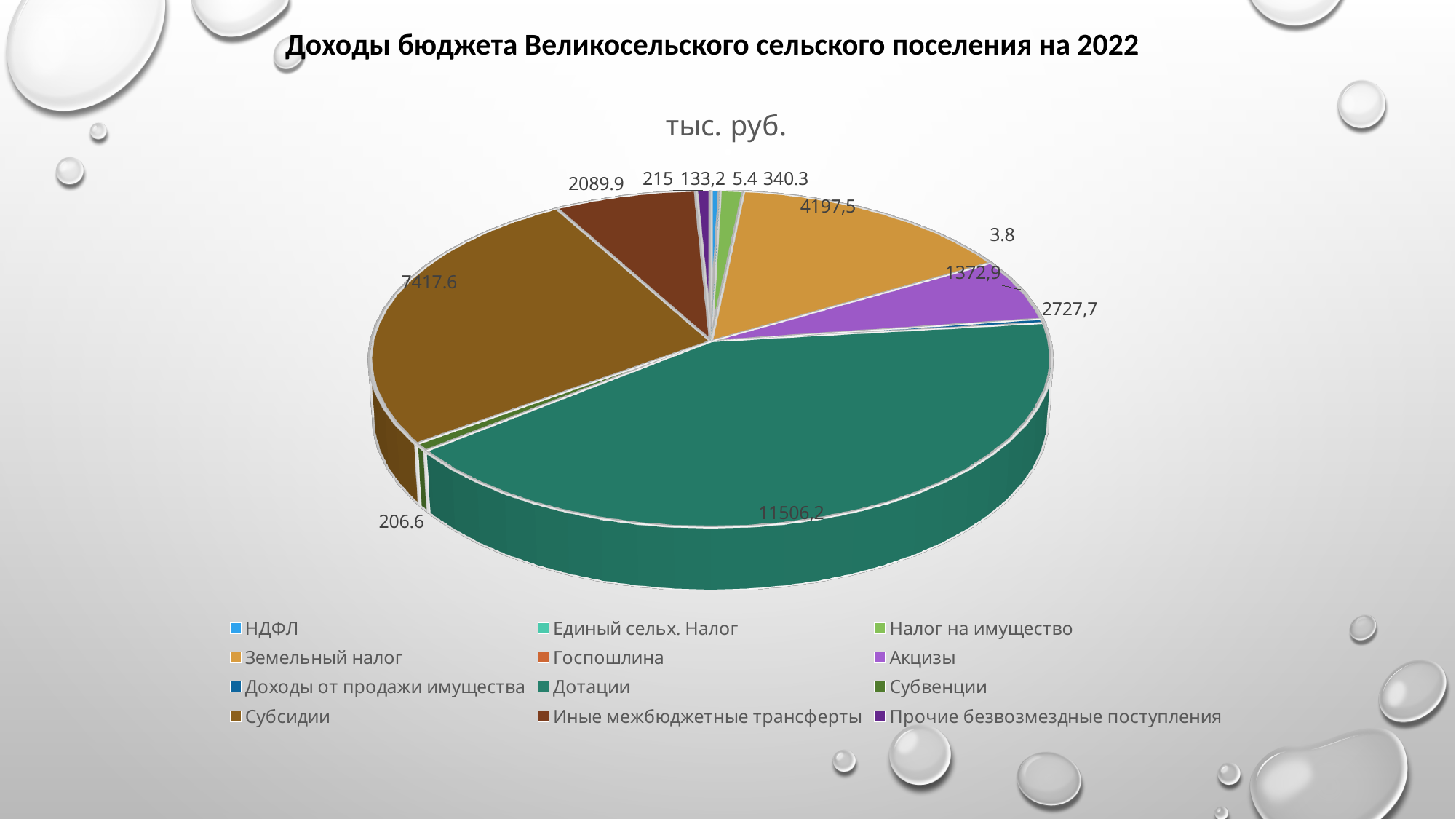
Which category has the largest slice of the pie? Дотации What colour is the slice for Дотации? teal (green) How many categories does the legend list? 12 What kind of chart is shown on the slide? pie chart What is the value for Акцизы? 1372,9 What is the value for Дотации? 11506,2 Which is larger, Субсидии or Земельный налог? Субсидии What is the title shown above the pie chart? тыс. руб. What is the value for Субсидии? 7417.6 What is the value for Иные межбюджетные трансферты? 2089.9 What is the difference between the values for Дотации and Субсидии? 4088.6 What is the value for Земельный налог? 4197,5